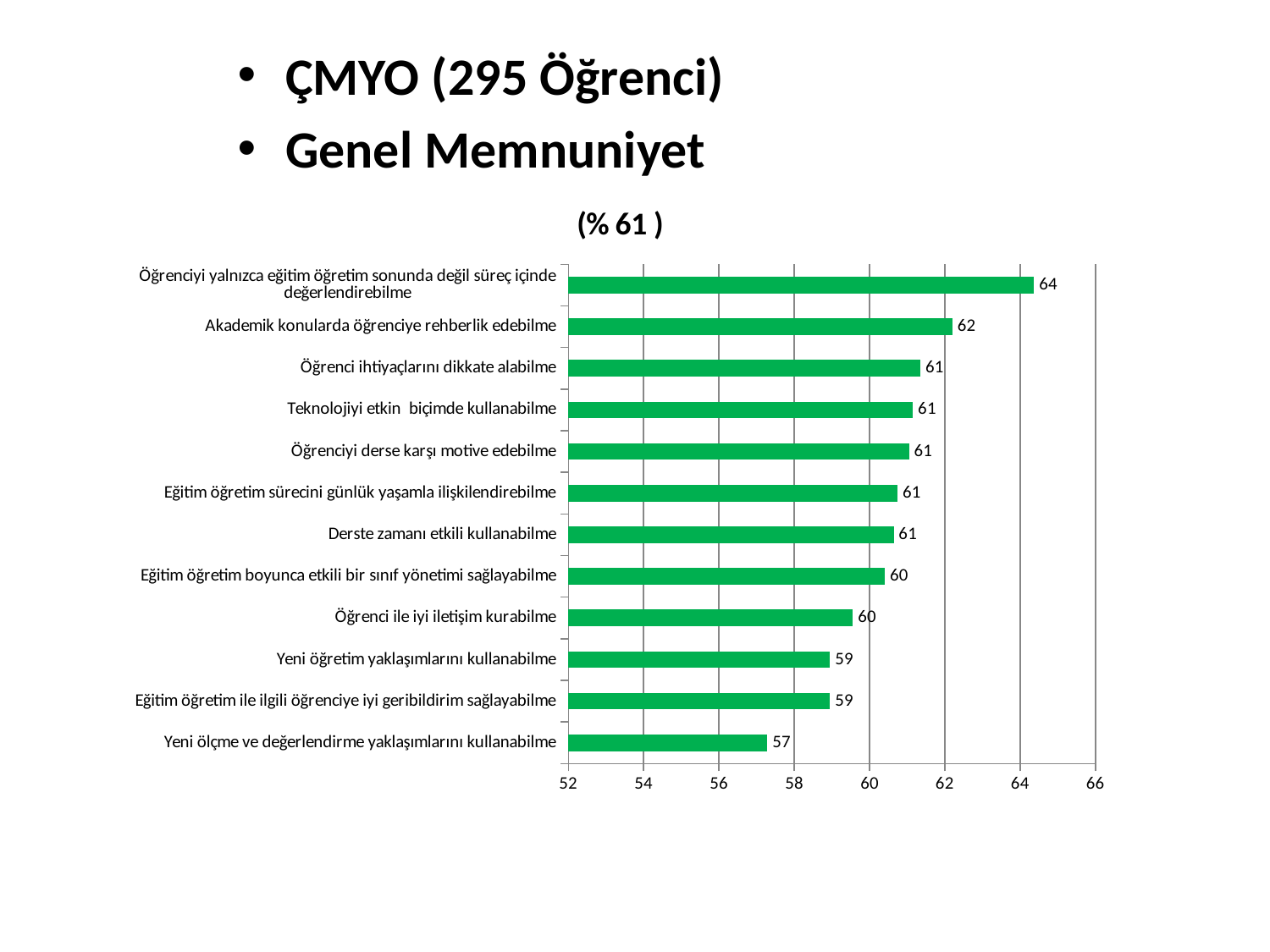
Which is larger: the value for "Akademik konularda öğrenciye rehberlik edebilme" or the value for "Yeni öğretim yaklaşımlarını kullanabilme"? Akademik konularda öğrenciye rehberlik edebilme How many categories are plotted in the chart? 12 What is the value for "Eğitim öğretim boyunca etkili bir sınıf yönetimi sağlayabilme"? 60 What kind of chart is shown on the slide? bar chart What is the title shown above the chart? (% 61 ) What is the value for "Yeni ölçme ve değerlendirme yaklaşımlarını kullanabilme"? 57 What is the value for "Akademik konularda öğrenciye rehberlik edebilme"? 62 Which category has the lowest value? Yeni ölçme ve değerlendirme yaklaşımlarını kullanabilme What is the value for "Teknolojiyi etkin biçimde kullanabilme"? 61 Which category has the highest value? Öğrenciyi yalnızca eğitim öğretim sonunda değil süreç içinde değerlendirebilme Is the value for "Öğrenci ile iyi iletişim kurabilme" greater or less than 58? greater What is the difference between the highest value (64) and the lowest value (57)? 7